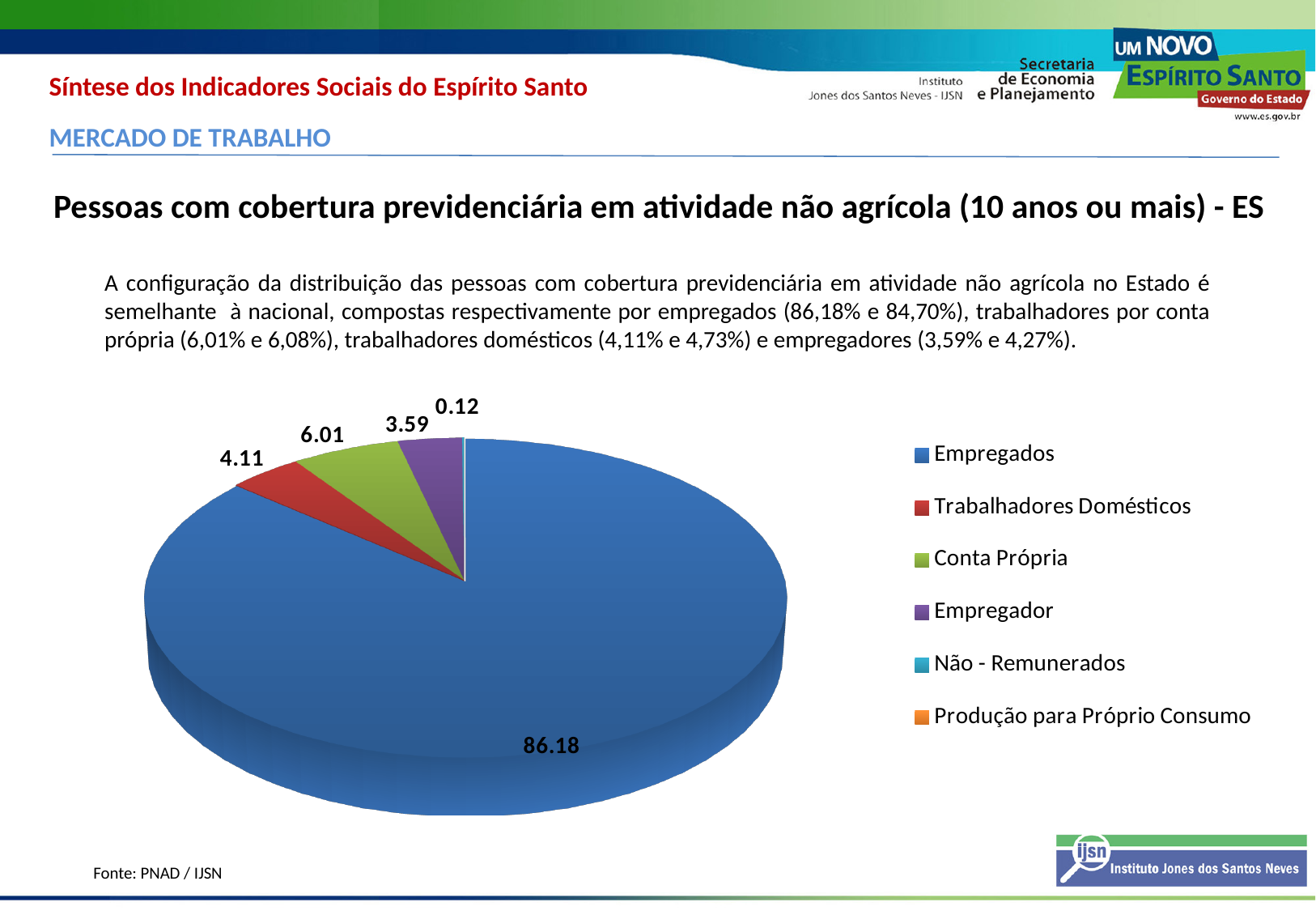
What value is shown for Empregador in the pie chart? 3.59 What value is shown for Empregados in the pie chart? 86.18 What is the difference between the values for Conta Própria and Trabalhadores Domésticos? 1.90 What is the title of the chart on the slide? Pessoas com cobertura previdenciária em atividade não agrícola (10 anos ou mais) - ES Which of the two is larger in the pie chart: Conta Própria or Trabalhadores Domésticos? Conta Própria What value is shown for Conta Própria in the pie chart? 6.01 How many categories does the legend of the pie chart list? 6 Which category has the largest slice of the pie chart? Empregados What colour is the Empregados slice in the pie chart? blue What value is shown for Trabalhadores Domésticos in the pie chart? 4.11 What kind of chart is shown on the slide? pie chart What is the difference between the values for Empregados and Conta Própria? 80.17